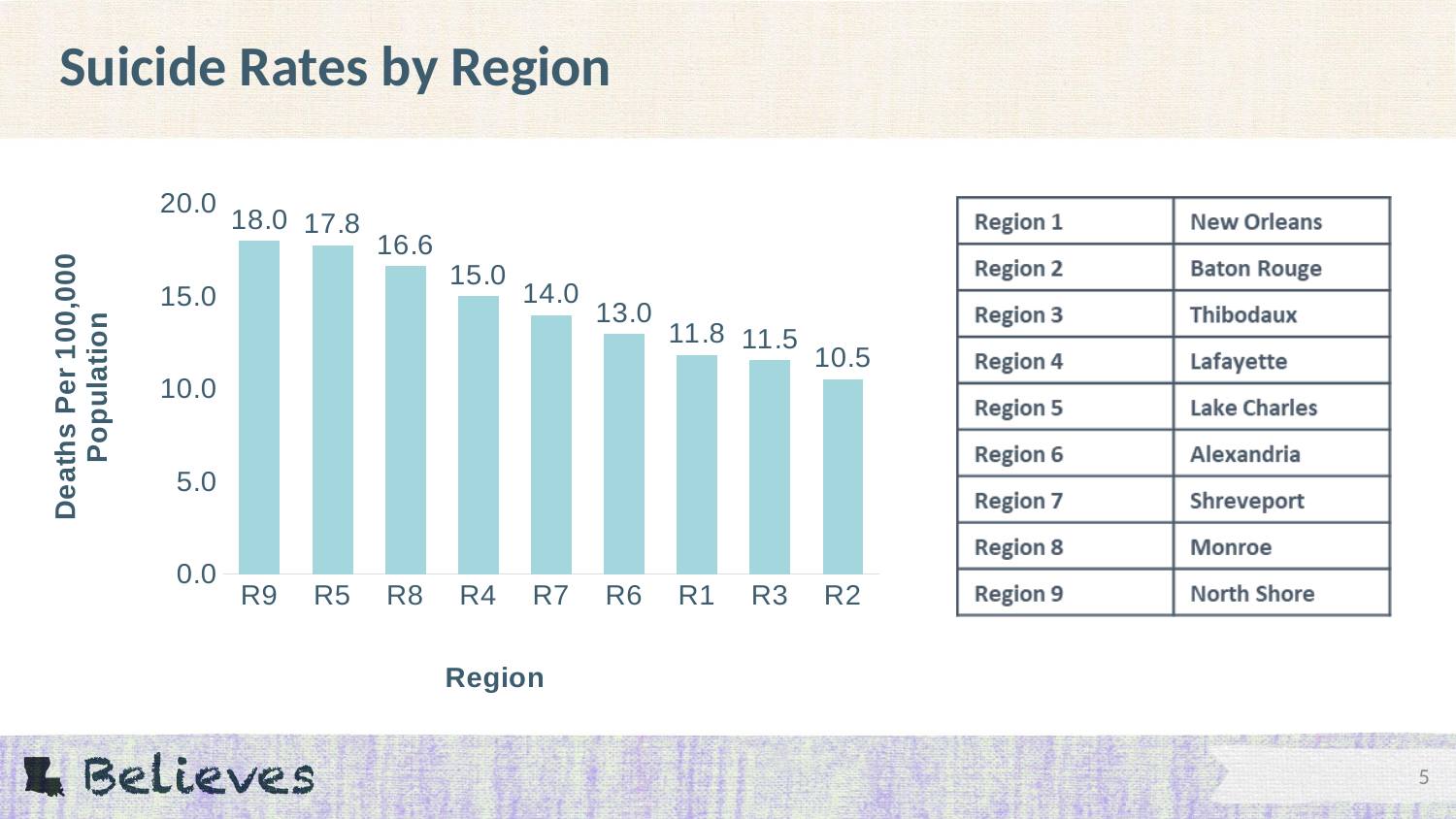
How many regions are shown on the x axis of the chart? 9 Do the values rise or fall moving from left to right along the x axis? Fall Which region has the highest suicide rate? R9 What is the value shown for R7? 14.0 What is the difference between the values for R9 and R2? 7.5 What kind of chart is shown on the slide? Bar chart What is the suicide rate (deaths per 100,000 population) for R9? 18.0 What is the difference between the values for R8 and R6? 3.6 Is the value for R5 greater or less than 15.0? greater Which has a higher value, R4 or R1? R4 What is the value shown for R3? 11.5 Which region has the lowest suicide rate? R2